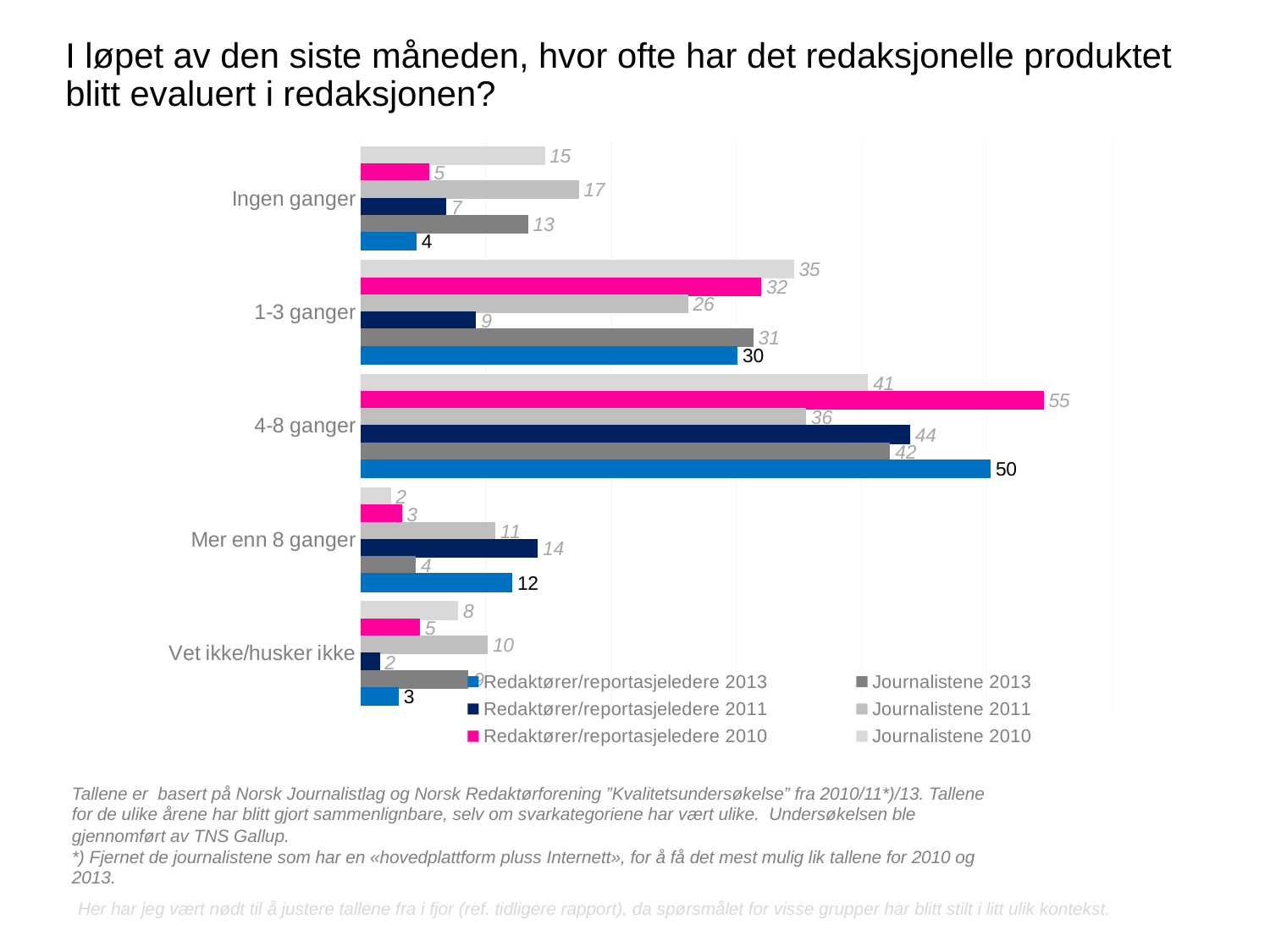
What is the difference between the Redaktører/reportasjeledere 2013 and Journalistene 2013 values in the 'Mer enn 8 ganger' category? 8 Which category has the lowest value for Journalistene 2010? Mer enn 8 ganger How many series does the legend list? 6 What is the value for Redaktører/reportasjeledere 2010 in the '4-8 ganger' category? 55 What is the value for Redaktører/reportasjeledere 2011 in the '1-3 ganger' category? 9 Which category has the highest value for Redaktører/reportasjeledere 2013? 4-8 ganger In the '1-3 ganger' category, which is larger: the value for Journalistene 2010 or for Journalistene 2011? Journalistene 2010 What is the value for Journalistene 2011 in the 'Ingen ganger' category? 17 How many response categories are shown on the chart? 5 What kind of chart is shown on the slide? bar chart Which series is shown in pink in the legend? Redaktører/reportasjeledere 2010 What is the value for Redaktører/reportasjeledere 2013 in the '4-8 ganger' category? 50